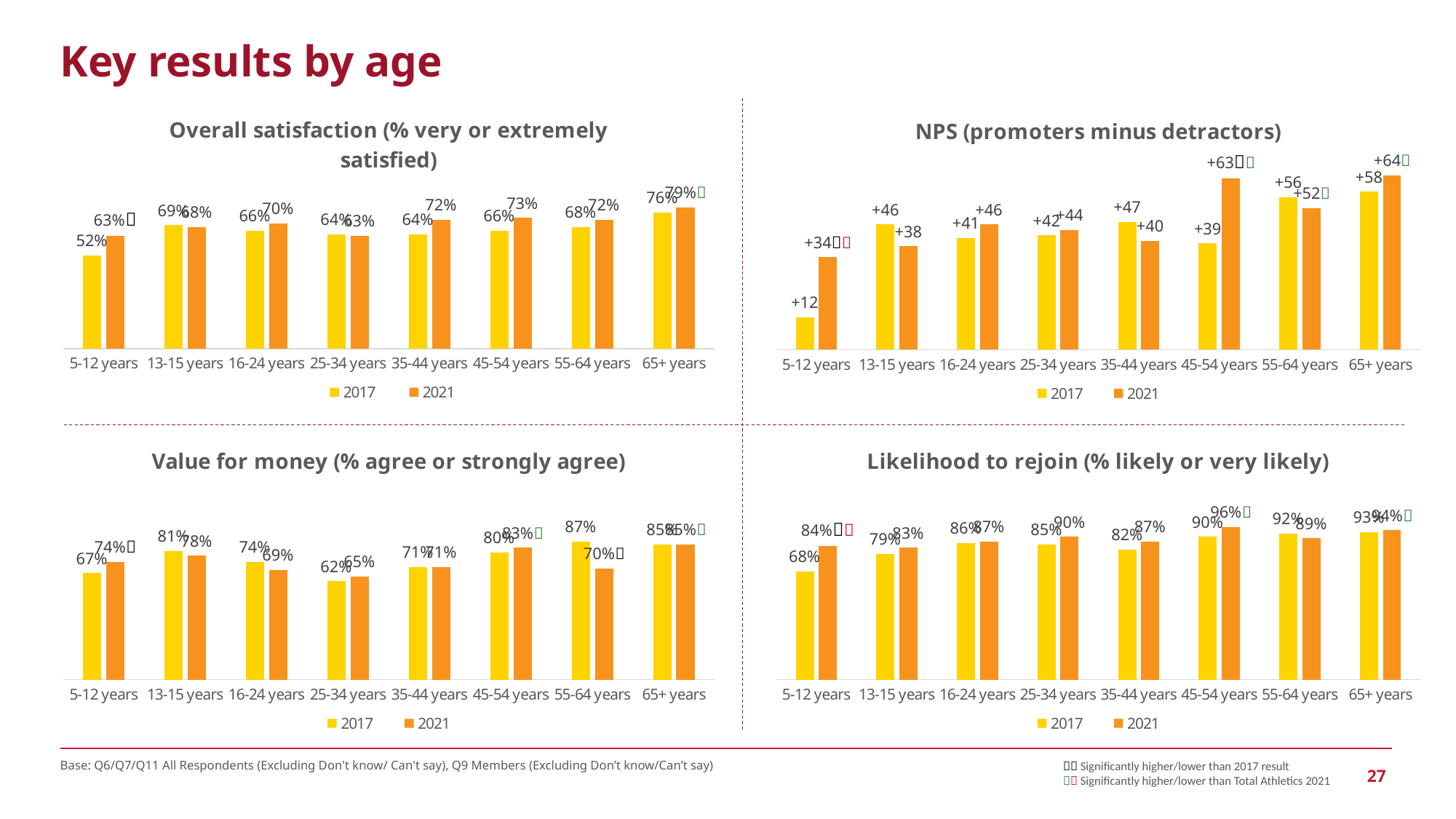
In the Value for money chart, what is the 2021 value for 55-64 years? 70% In the Overall satisfaction chart, what is the 2017 value for 5-12 years? 52% In the Overall satisfaction chart, which is larger for 35-44 years, the 2017 value or the 2021 value? 2021 What type of chart is the Likelihood to rejoin chart? Bar chart In the NPS (promoters minus detractors) chart, what is the difference between the 2021 and 2017 values for 5-12 years? 22 In the Likelihood to rejoin chart, what is the 2017 value for 5-12 years? 68% In the Likelihood to rejoin chart, which age group has the highest 2021 value? 45-54 years In the NPS (promoters minus detractors) chart, which age group has the lowest 2017 value? 5-12 years How many series does the legend of the NPS (promoters minus detractors) chart list? 2 In the Value for money chart, what is the difference between the 2017 and 2021 values for 55-64 years? 17% In the NPS (promoters minus detractors) chart, what is the 2021 value for 45-54 years? +63 How many age groups are shown in the Value for money chart? 8